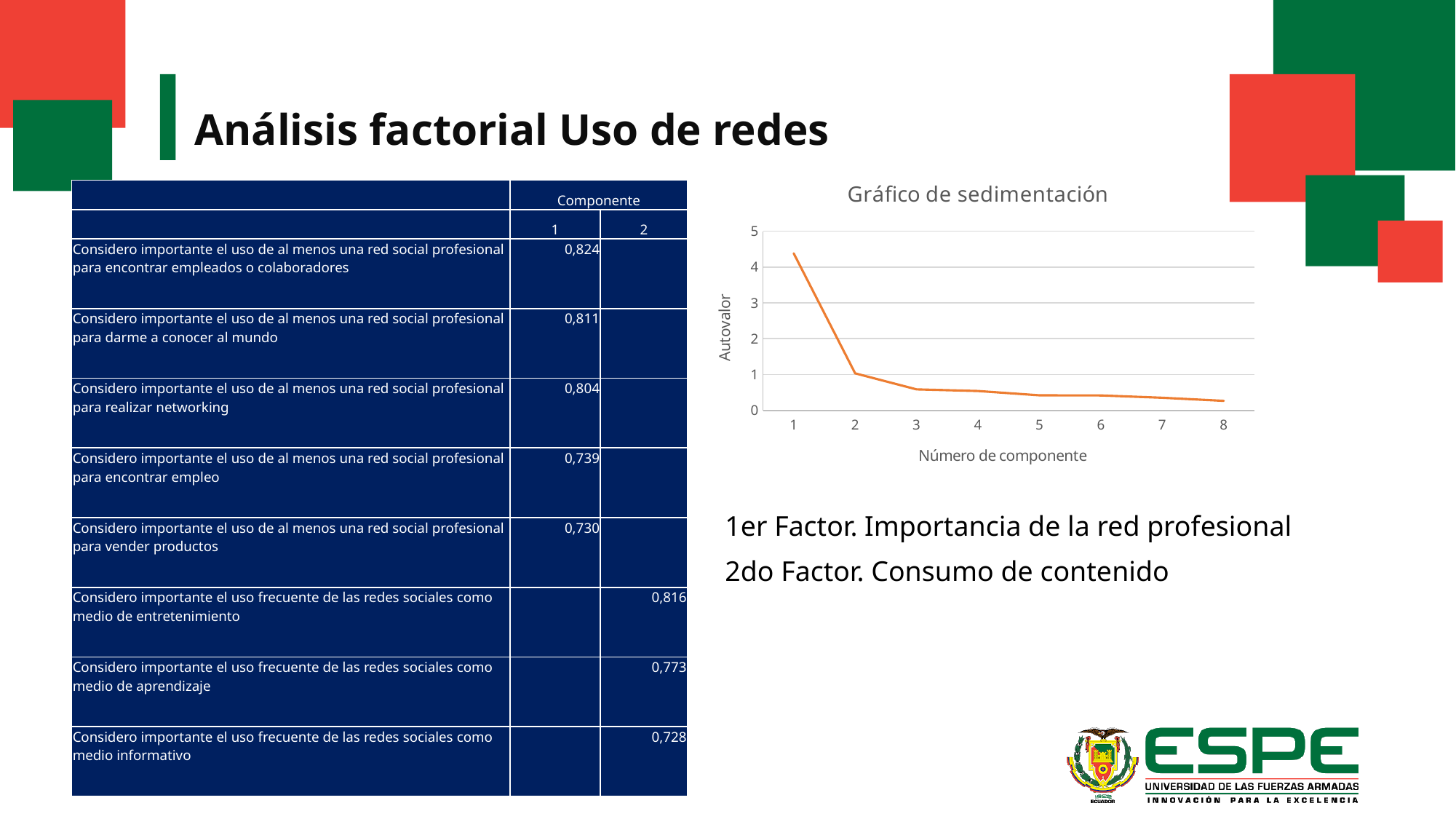
In the 'Gráfico de sedimentación', do the eigenvalues rise or fall as the component number increases? fall What is the label of the x axis in the 'Gráfico de sedimentación'? Número de componente Which component has the highest eigenvalue in the 'Gráfico de sedimentación'? 1 In the 'Gráfico de sedimentación', is the eigenvalue for component 2 greater or less than 2? less In the 'Gráfico de sedimentación', which has a larger eigenvalue, component 1 or component 2? component 1 In the 'Gráfico de sedimentación', is the eigenvalue for component 1 greater or less than 4? greater In the 'Gráfico de sedimentación', is the eigenvalue for component 3 greater or less than 1? less How many components are plotted on the x axis of the 'Gráfico de sedimentación'? 8 What kind of chart is the 'Gráfico de sedimentación'? line chart What is the label of the y axis in the 'Gráfico de sedimentación'? Autovalor Which component has the lowest eigenvalue in the 'Gráfico de sedimentación'? 8